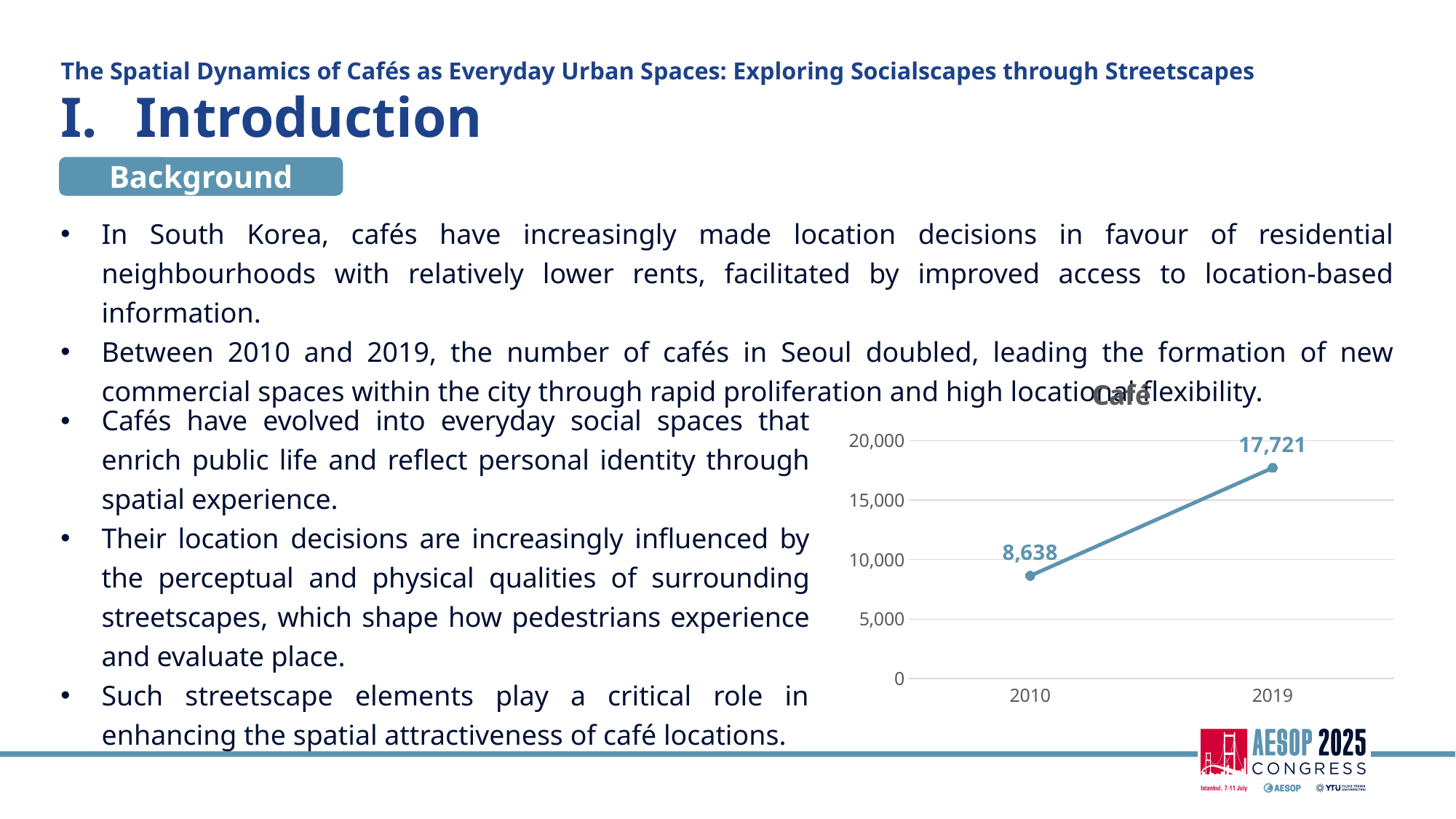
What is the difference between the 2019 and 2010 values in the chart? 9,083 Is the value for 2019 greater or less than 15,000? greater What is the title of the chart? Café Is the value for 2010 greater or less than 10,000? less Which year has the lower value in the chart? 2010 How many data points are plotted in the chart? 2 What is the value for 2010 in the chart? 8,638 Do the values rise or fall from 2010 to 2019? Rise What kind of chart is shown on the slide? Line chart What is the value for 2019 in the chart? 17,721 Which year has the higher value in the chart? 2019 Is the value for 2019 larger than the value for 2010? Yes